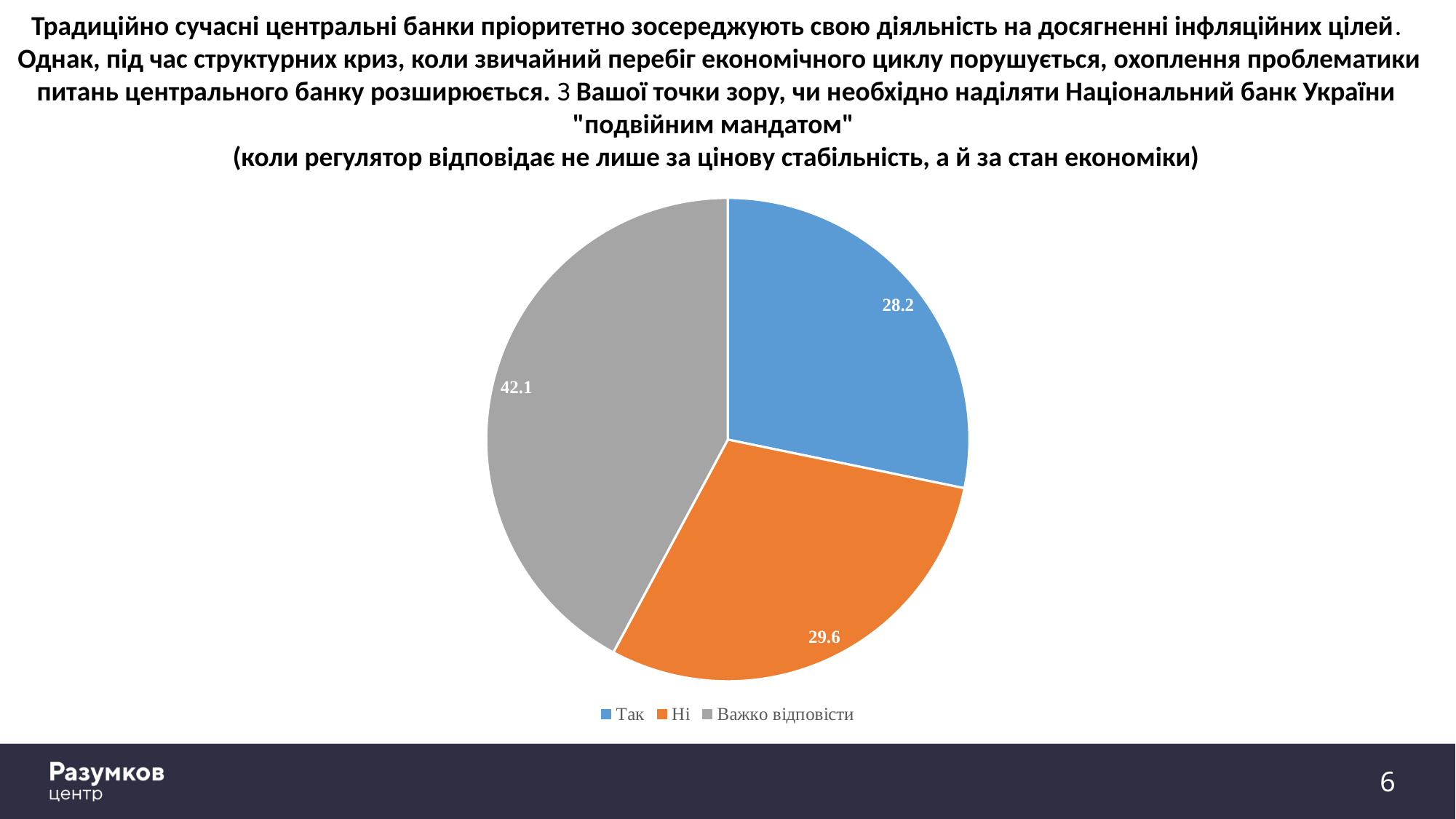
What is the difference between the values for "Ні" and "Так"? 1.4 Which category has the largest slice of the pie chart? Важко відповісти What is the value shown for the "Важко відповісти" slice of the pie chart? 42.1 What kind of chart is shown on the slide? pie chart Which is larger, the value for "Важко відповісти" or the value for "Так"? Важко відповісти What colour is the "Так" slice in the pie chart? blue Which category has the smallest slice of the pie chart? Так What is the value shown for the "Ні" slice of the pie chart? 29.6 How many slices does the pie chart have? 3 What is the difference between the values for "Важко відповісти" and "Ні"? 12.5 How many entries does the legend of the pie chart list? 3 What is the value shown for the "Так" slice of the pie chart? 28.2